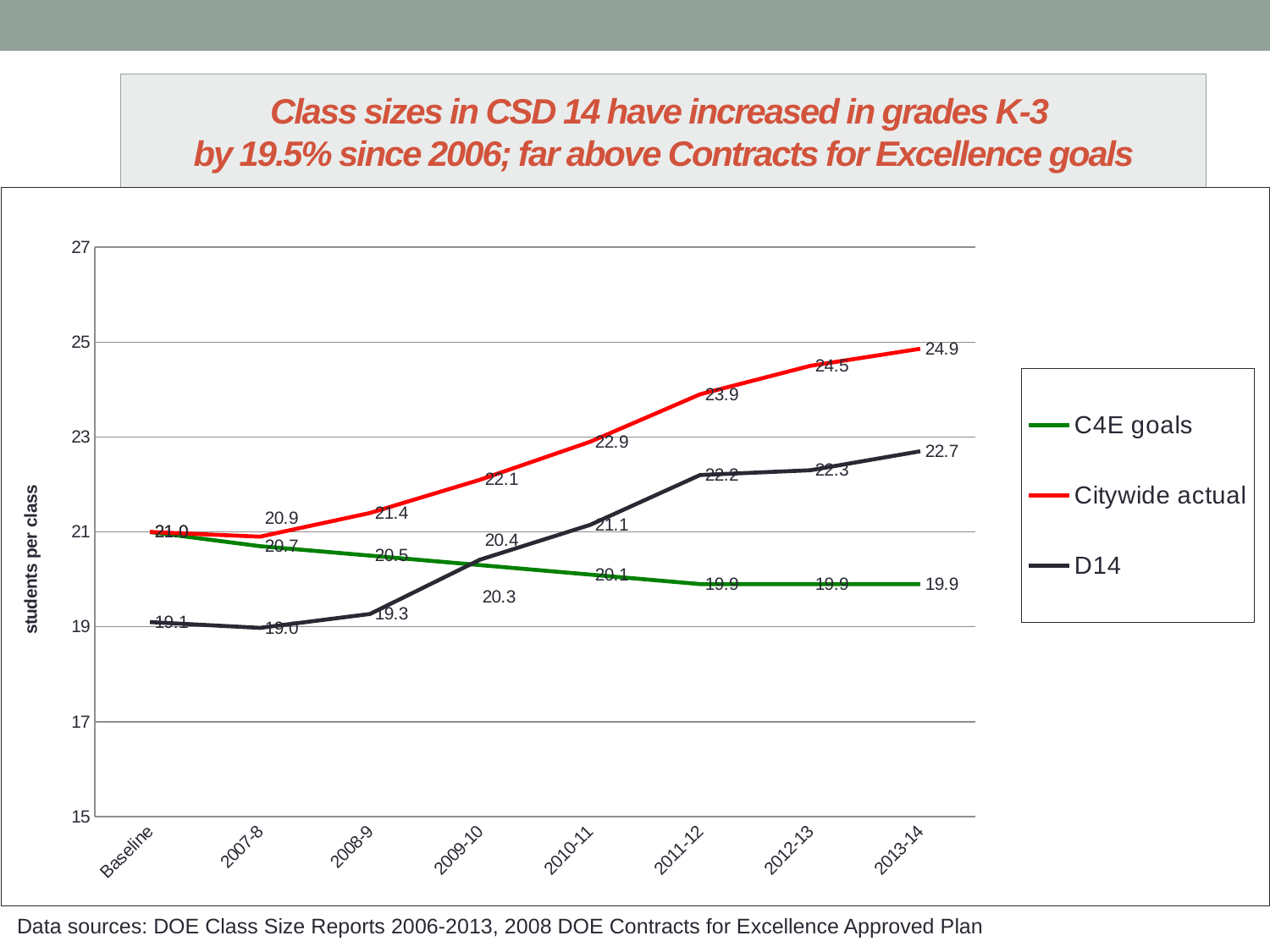
What kind of chart is shown on the slide? line chart Does the C4E goals series rise or fall from Baseline to 2013-14? fall In 2011-12, which is larger: the Citywide actual value or the D14 value? Citywide actual What is the label on the y axis? students per class In which year is the D14 series at its lowest value? 2007-8 What is the Citywide actual value for 2013-14? 24.9 What is the C4E goals value for 2013-14? 19.9 How many series does the legend list? 3 What is the difference between the Citywide actual and D14 values in 2013-14? 2.2 What is the D14 value for 2013-14? 22.7 In which year does the Citywide actual series reach its highest value? 2013-14 How many points are plotted along the x axis for each series? 8